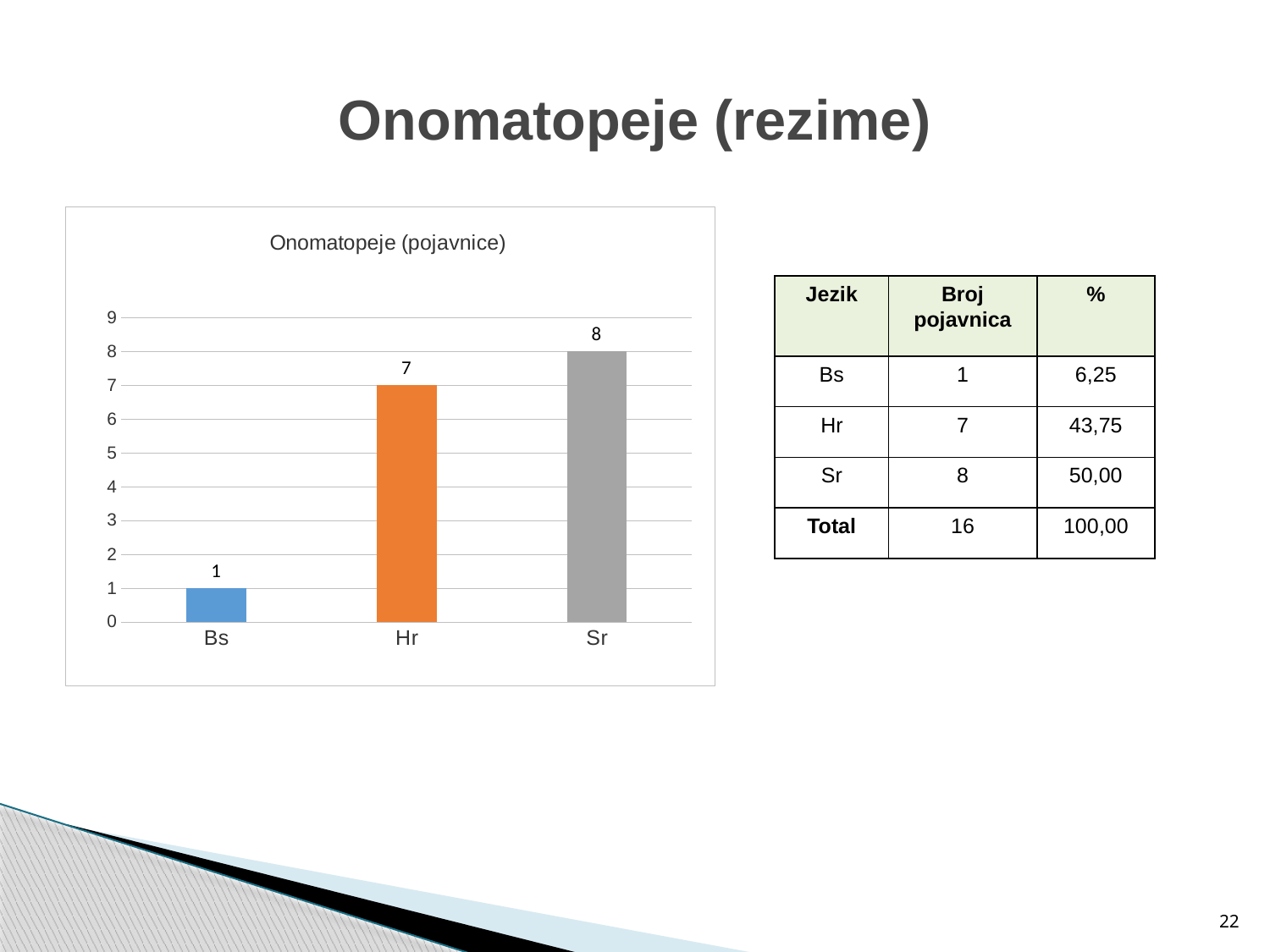
What is the difference between the values for Sr and Hr? 1 What is the value for Bs in the chart? 1 What is the value for Sr in the chart? 8 How many categories are shown on the x axis of the chart? 3 What kind of chart is shown on the slide? bar chart What is the title of the chart? Onomatopeje (pojavnice) Which category has the highest value in the chart? Sr Which is larger, the value for Hr or the value for Bs? Hr What is the value for Hr in the chart? 7 Which category has the lowest value in the chart? Bs Is the value for Sr greater or less than 5? greater What is the difference between the values for Hr and Bs? 6